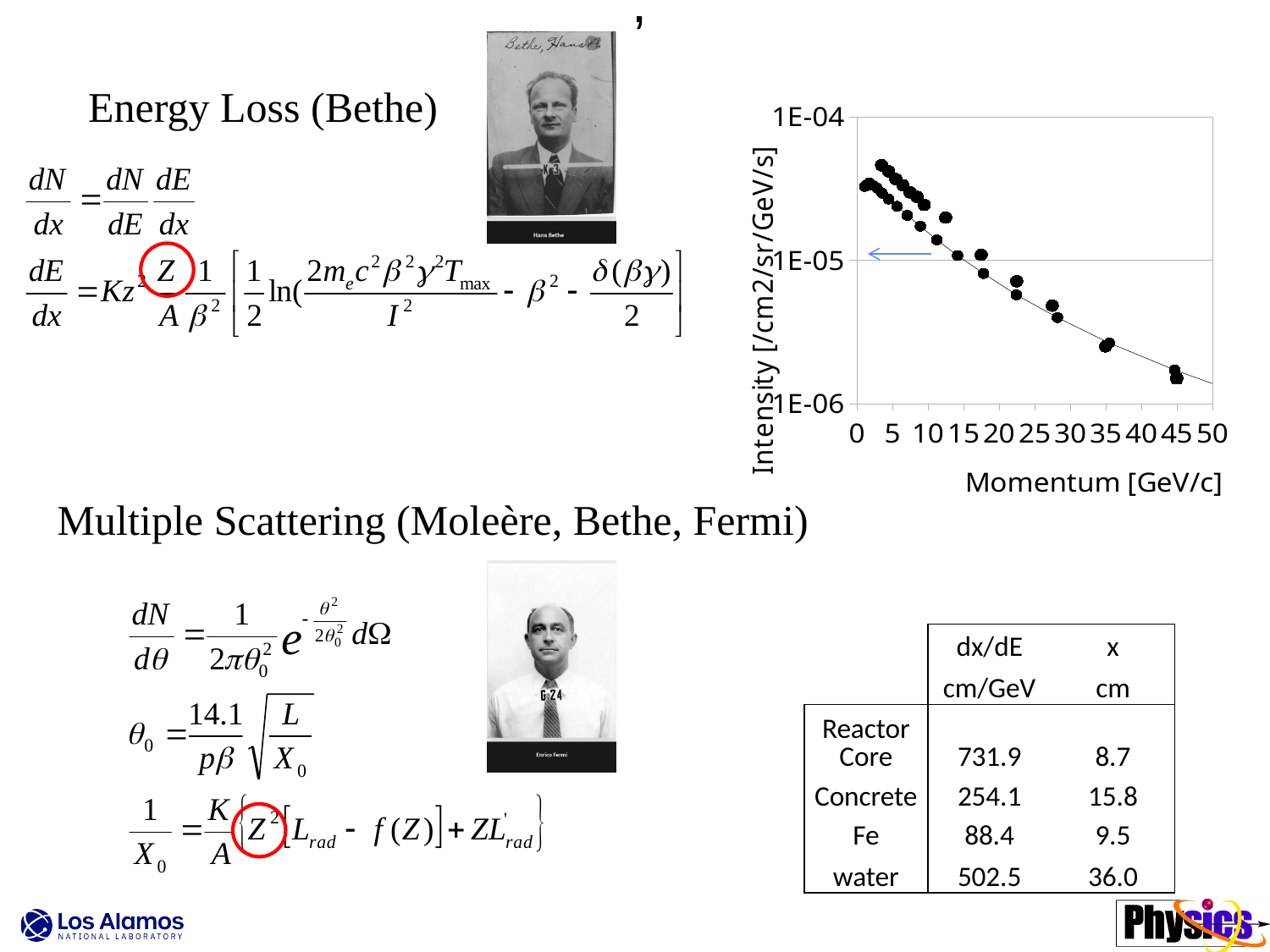
Is the intensity at a momentum of about 35 GeV/c greater or less than 1E-05? less Does the intensity rise or fall as momentum increases along the x axis? fall What is the label of the x axis of the chart? Momentum [GeV/c] What is the label of the y axis of the chart? Intensity [/cm2/sr/GeV/s] Is the intensity at a momentum of about 5 GeV/c greater or less than 1E-05? greater What kind of chart is shown on the slide? scatter chart Which has the higher intensity: the points near 5 GeV/c or the points near 45 GeV/c? the points near 5 GeV/c Is the intensity at a momentum of about 45 GeV/c greater or less than 1E-05? less What is the highest momentum value shown on the x axis? 50